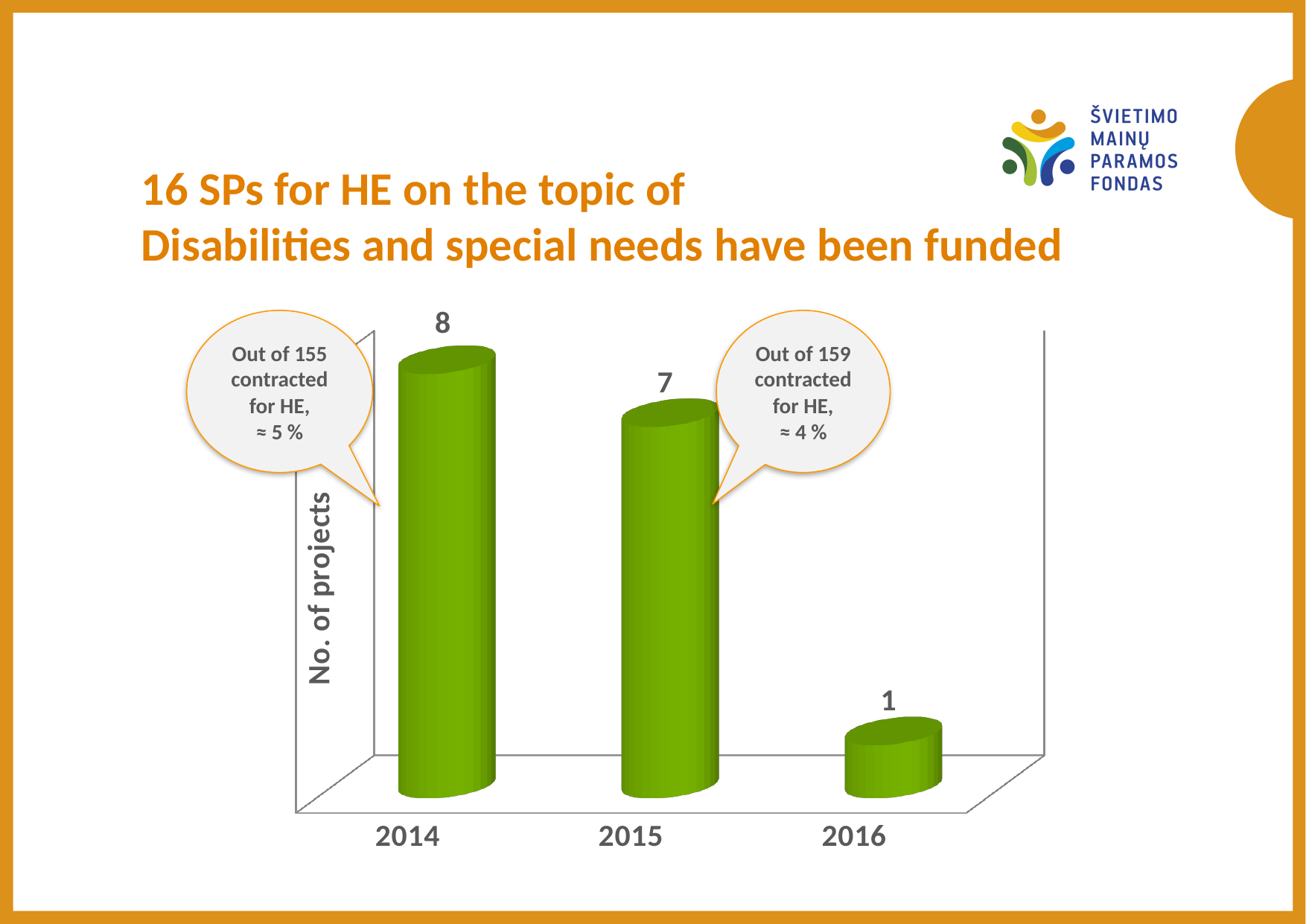
What kind of chart is shown on the slide? Bar chart Which year has the highest number of projects? 2014 Do the values rise or fall from 2014 to 2016? Fall What is the number of projects for 2016? 1 What is the difference in the number of projects between 2014 and 2015? 1 Which year has more projects, 2015 or 2016? 2015 What is the number of projects for 2014? 8 Which year has the lowest number of projects? 2016 What is the number of projects for 2015? 7 What is the label of the vertical axis of the chart? No. of projects How many years are shown on the x axis of the chart? 3 What is the difference in the number of projects between 2014 and 2016? 7